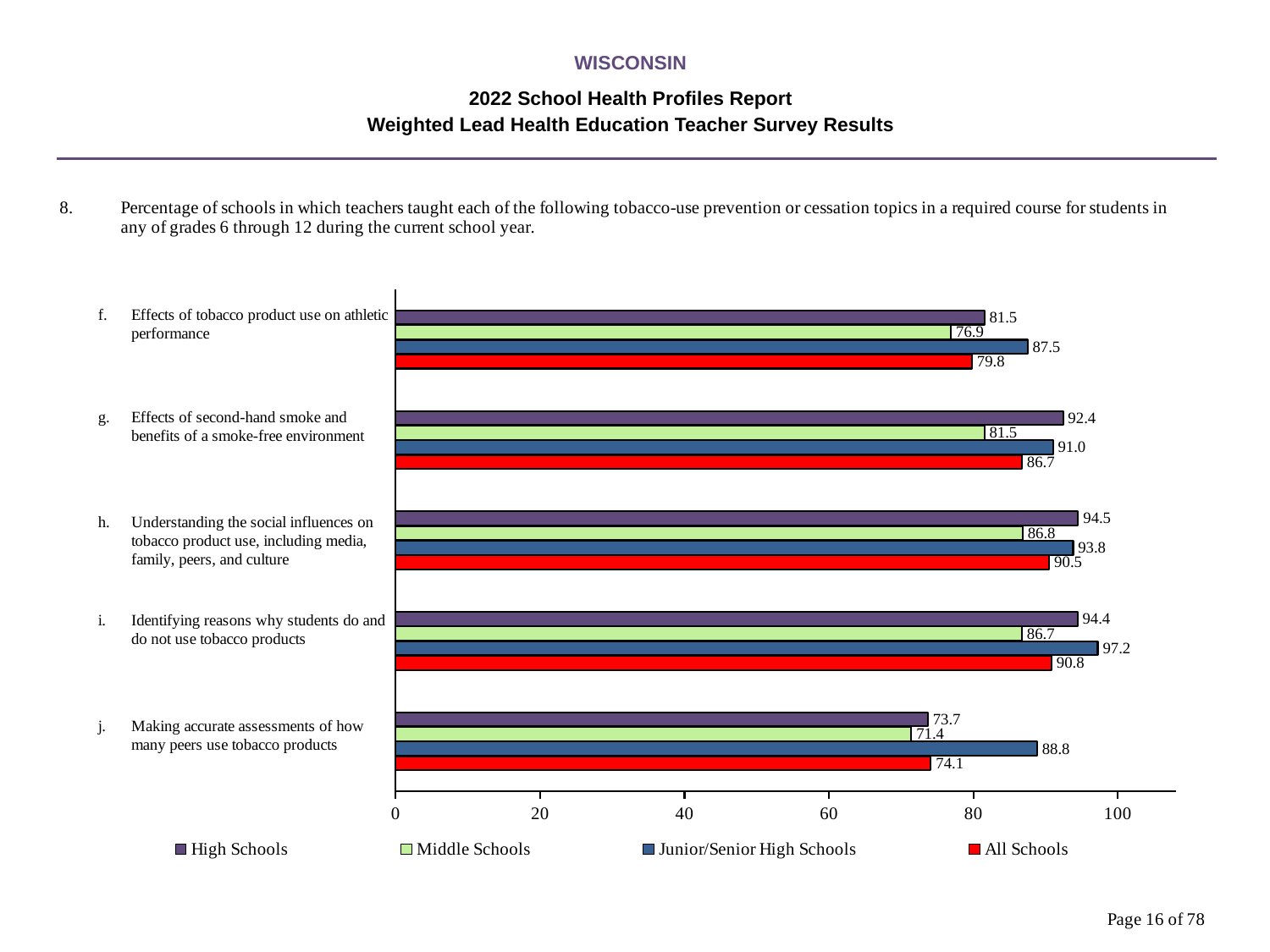
Which topic has the lowest Middle Schools value? j. Making accurate assessments of how many peers use tobacco products What kind of chart is shown on the slide? Bar chart What is the value for High Schools for topic f, effects of tobacco product use on athletic performance? 81.5 How many series does the legend list? 4 For topic h, which is larger: the High Schools value or the Junior/Senior High Schools value? High Schools Which colour represents All Schools in the legend? Red Which topic has the highest All Schools value? i. Identifying reasons why students do and do not use tobacco products What is the All Schools value for topic g, effects of second-hand smoke and benefits of a smoke-free environment? 86.7 What is the difference between the Junior/Senior High Schools and Middle Schools values for topic j? 17.4 What is the value for Junior/Senior High Schools for topic i, identifying reasons why students do and do not use tobacco products? 97.2 How many topics are shown on the chart? 5 What is the value for Middle Schools for topic j, making accurate assessments of how many peers use tobacco products? 71.4